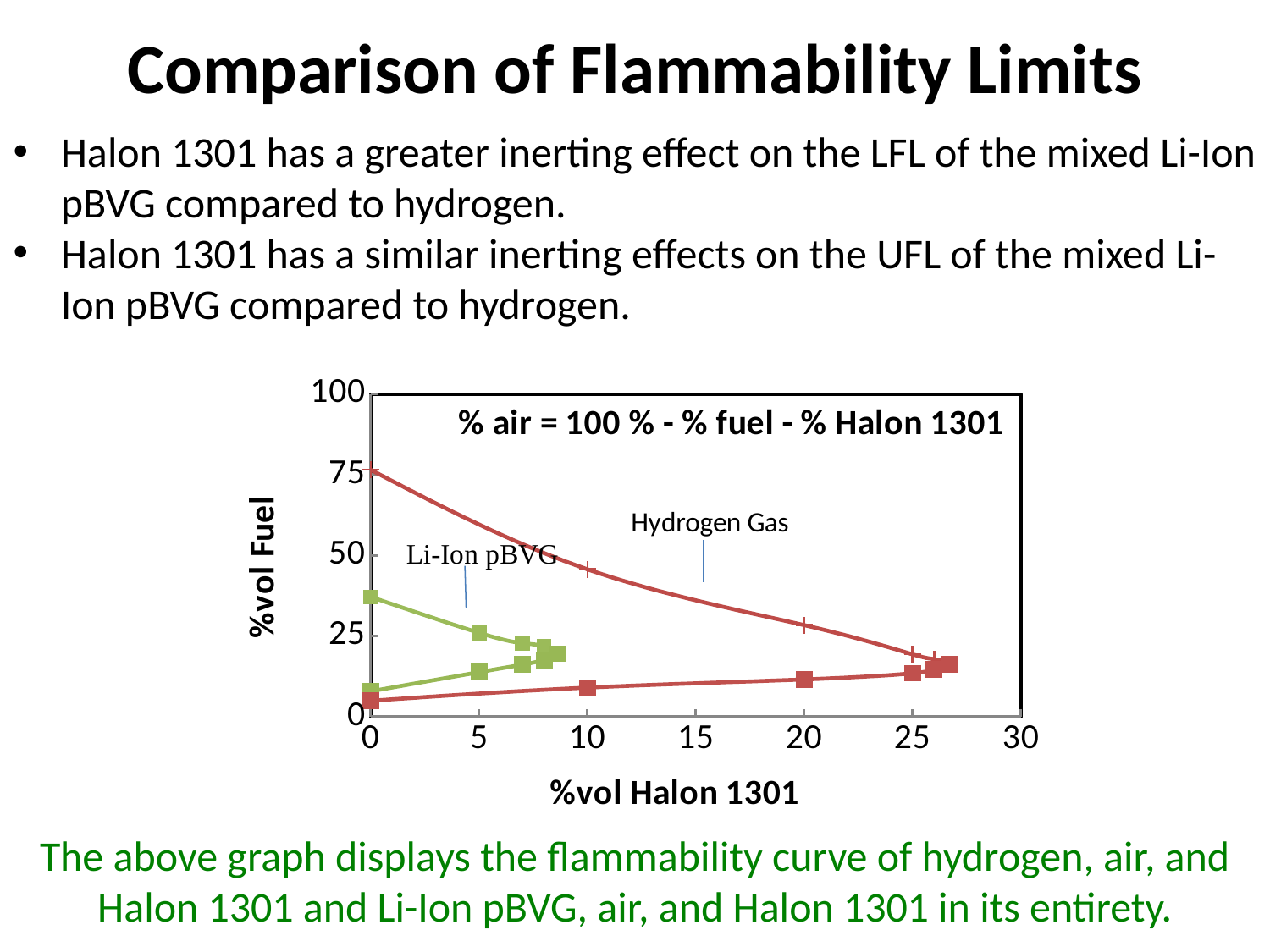
How many data series are plotted on the chart? 4 What is the title of the x axis of the chart? %vol Halon 1301 Is the maximum %vol Halon 1301 reached by the Hydrogen Gas curve greater or less than 25? greater Does the lower branch of the Li-Ion pBVG curve rise or fall as %vol Halon 1301 increases? rise Is the upper flammability limit of Hydrogen Gas at 0 %vol Halon 1301 greater or less than 50 %vol Fuel? greater Is the maximum %vol Halon 1301 reached by the Li-Ion pBVG curve greater or less than 10? less Which series extends further along the %vol Halon 1301 axis, Hydrogen Gas or Li-Ion pBVG? Hydrogen Gas Does the upper branch of the Hydrogen Gas curve rise or fall as %vol Halon 1301 increases? fall At 0 %vol Halon 1301, which series has the higher upper flammability limit, Hydrogen Gas or Li-Ion pBVG? Hydrogen Gas What kind of chart is shown on the slide? line chart What is the title of the y axis of the chart? %vol Fuel